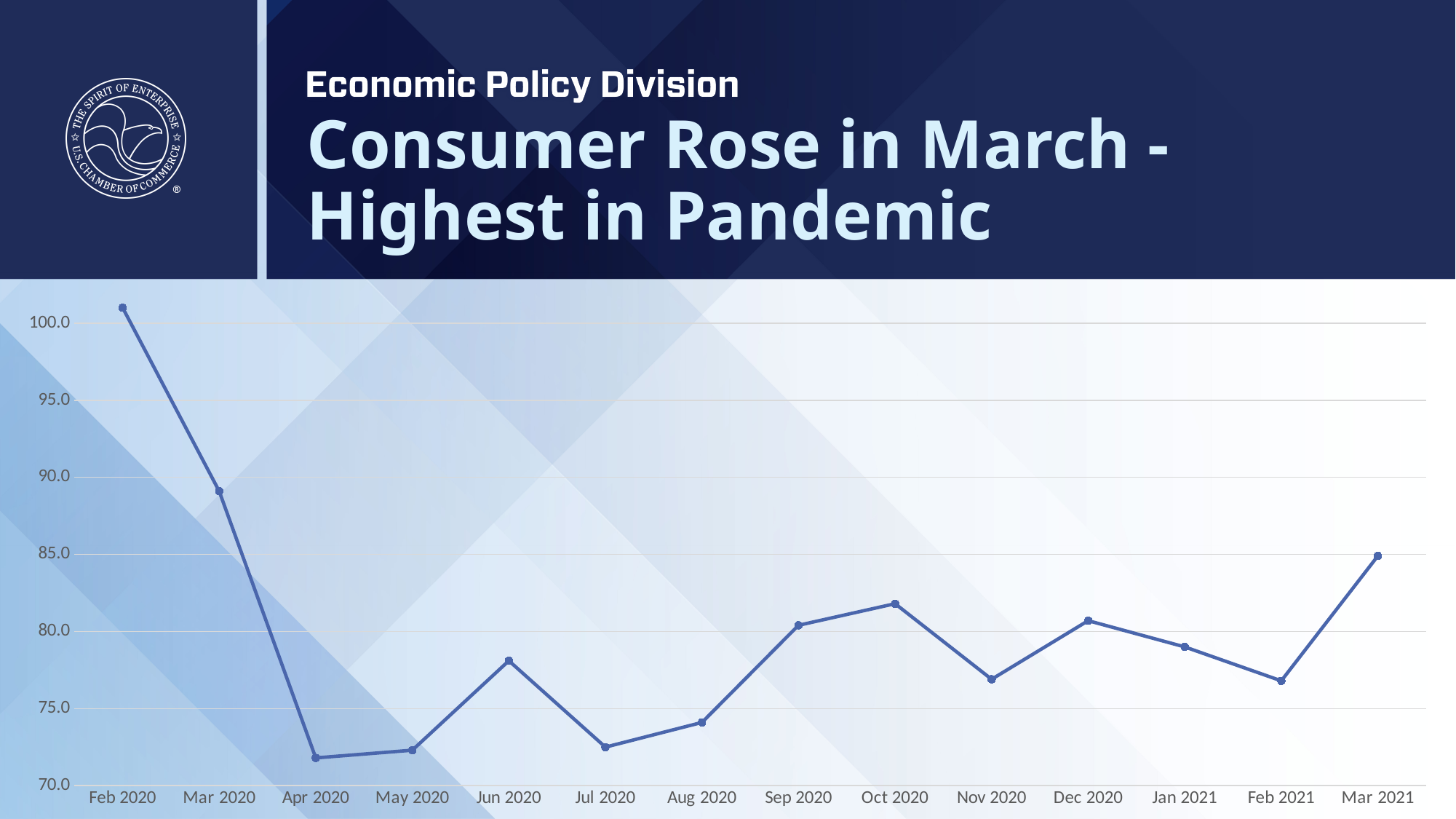
Is the value for Feb 2020 greater or less than 100.0? greater What kind of chart is shown on the slide? line chart Which month has the highest value on the chart? Feb 2020 Is the value for Apr 2020 greater or less than 75.0? less Do the values rise or fall from Feb 2020 to Apr 2020? fall Is the value for Oct 2020 greater or less than 85.0? less Which is larger, the value for Mar 2021 or the value for Feb 2021? Mar 2021 What is the title of the slide containing the chart? Consumer Rose in March - Highest in Pandemic How many months are plotted on the x axis of the chart? 14 Which is larger, the value for Jun 2020 or the value for Jul 2020? Jun 2020